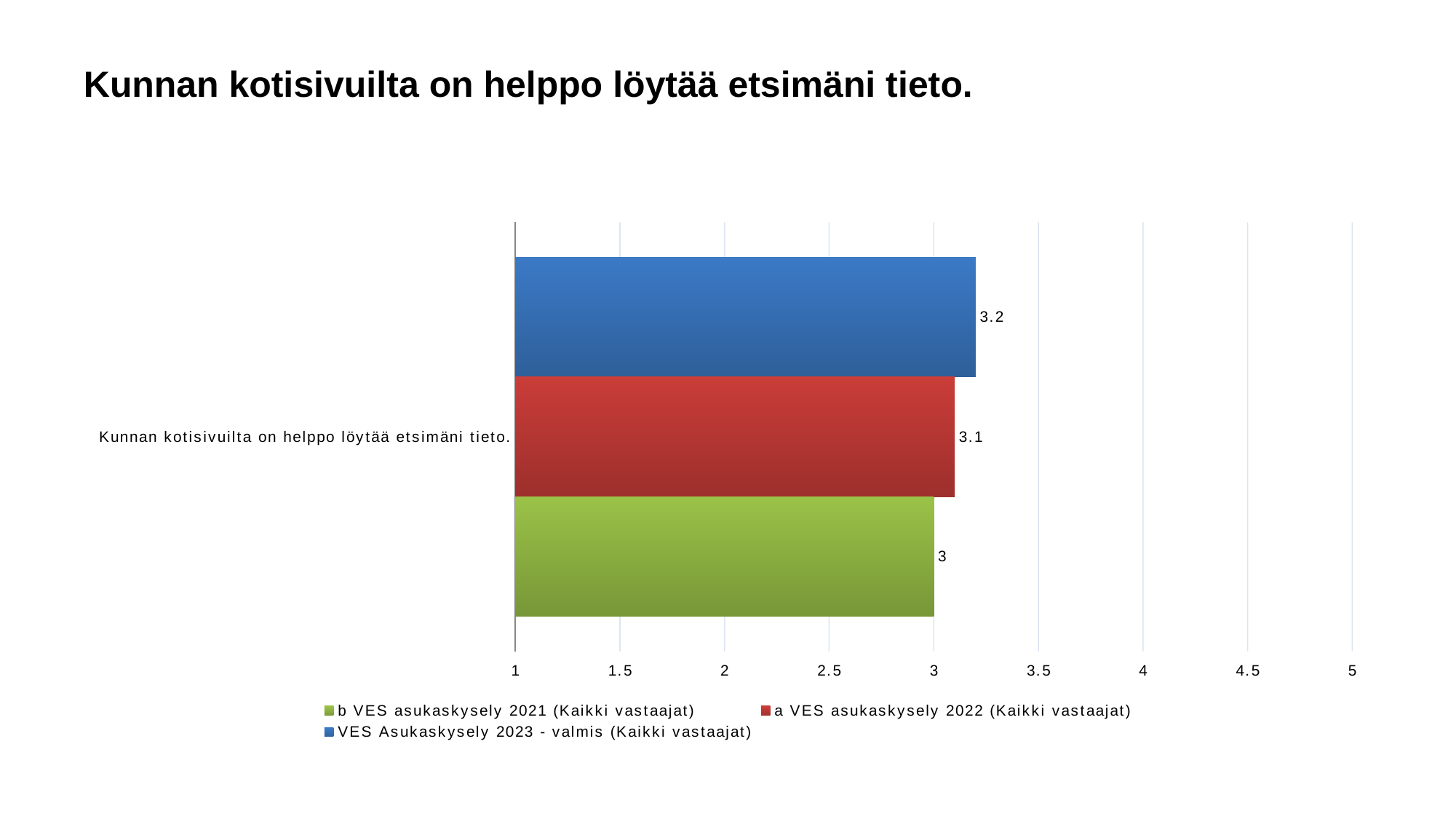
What is the value for the series 'VES Asukaskysely 2023 - valmis (Kaikki vastaajat)'? 3.2 Which series has the lowest value? b VES asukaskysely 2021 (Kaikki vastaajat) What is the difference between the 2023 value and the 2021 value? 0.2 What is the value for the series 'b VES asukaskysely 2021 (Kaikki vastaajat)'? 3 Which is larger, the value for 2022 or the value for 2021? 2022 Which series has the highest value? VES Asukaskysely 2023 - valmis (Kaikki vastaajat) What kind of chart is shown on the slide? bar chart How many series does the legend list? 3 Do the values rise or fall from the 2021 survey to the 2023 survey? rise What is the title of the chart? Kunnan kotisivuilta on helppo löytää etsimäni tieto. What is the value for the series 'a VES asukaskysely 2022 (Kaikki vastaajat)'? 3.1 Is the value for 'VES Asukaskysely 2023 - valmis (Kaikki vastaajat)' greater or less than 3.5? less